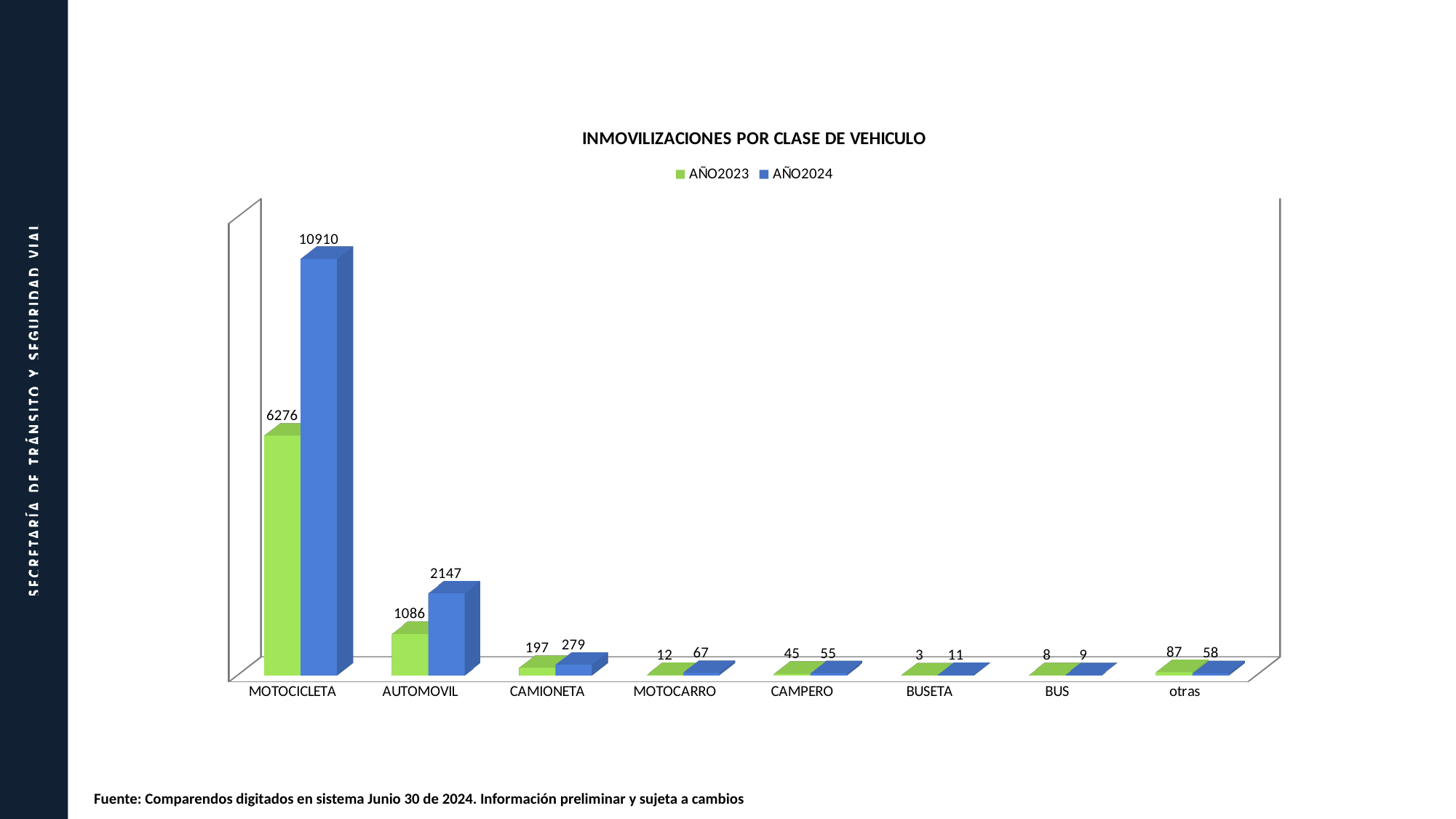
How many vehicle categories are shown on the x axis? 8 How many series does the legend list? 2 Which category has the highest value in the AÑO2024 series? MOTOCICLETA What is the value for BUSETA in the AÑO2023 series? 3 Which is larger for otras: the AÑO2023 value or the AÑO2024 value? AÑO2023 What is the value for AUTOMOVIL in the AÑO2023 series? 1086 What is the difference between the AÑO2024 and AÑO2023 values for MOTOCICLETA? 4634 What kind of chart is shown on the slide? Bar chart What is the title of the chart? INMOVILIZACIONES POR CLASE DE VEHICULO What is the value for MOTOCICLETA in the AÑO2024 series? 10910 What is the value for CAMIONETA in the AÑO2024 series? 279 Which category has the lowest value in the AÑO2023 series? BUSETA